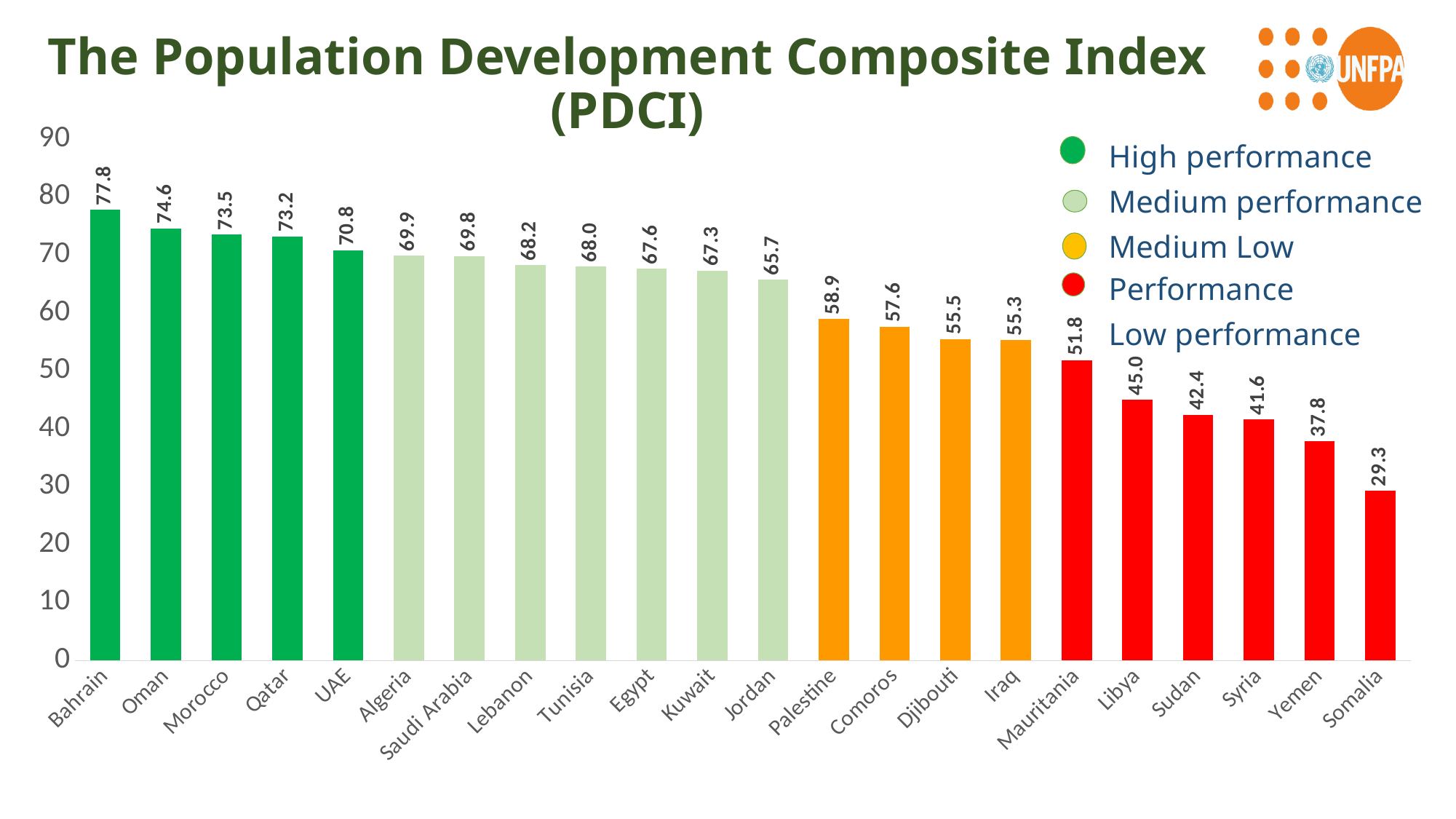
What is the PDCI value for Bahrain? 77.8 What is the PDCI value for Mauritania? 51.8 What is the difference between the PDCI values of Bahrain and Somalia? 48.5 Do the values rise or fall from left to right along the x axis? Fall How many countries are shown in the chart? 22 Which country has the highest PDCI value? Bahrain Which country has the lowest PDCI value? Somalia Which has a higher PDCI value, Libya or Sudan? Libya What is the difference between the PDCI values of Palestine and Iraq? 3.6 What is the PDCI value for Jordan? 65.7 Is the value for Yemen greater or less than 40? less What kind of chart is shown on the slide? Bar chart